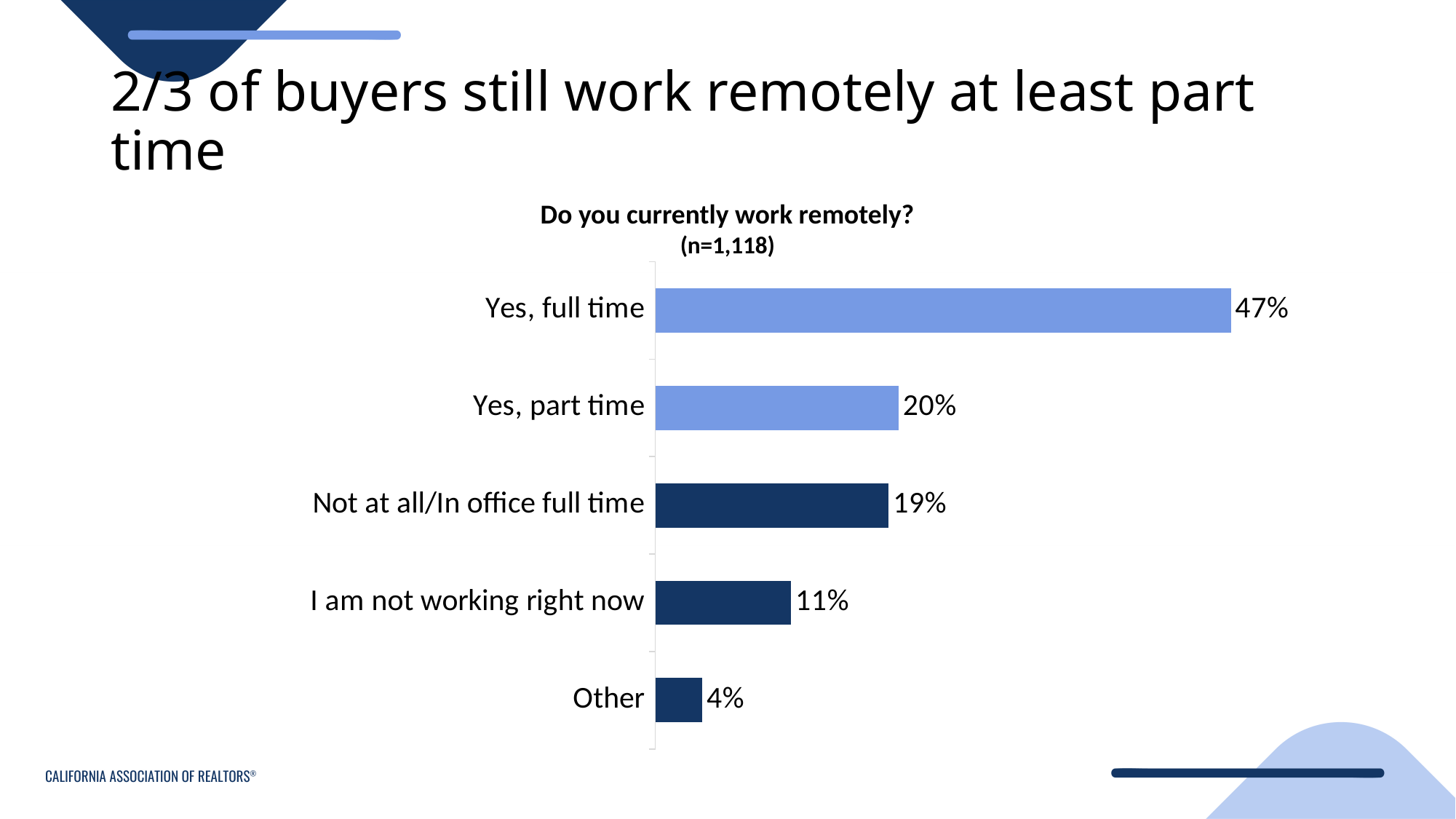
What is the combined value of "Yes, full time" and "Yes, part time"? 67% What percentage of respondents said "I am not working right now"? 11% Which category has the highest value? Yes, full time Which category has the lowest value? Other Which is larger: "Yes, part time" or "Not at all/In office full time"? Yes, part time What percentage of respondents answered "Yes, full time"? 47% What is the difference between "Yes, full time" and "Yes, part time"? 27% What kind of chart is shown on the slide? Bar chart What is the value for "Not at all/In office full time"? 19% How many categories are shown in the chart? 5 What is the value for "Other"? 4% What is the sample size (n) shown in the chart title? 1,118